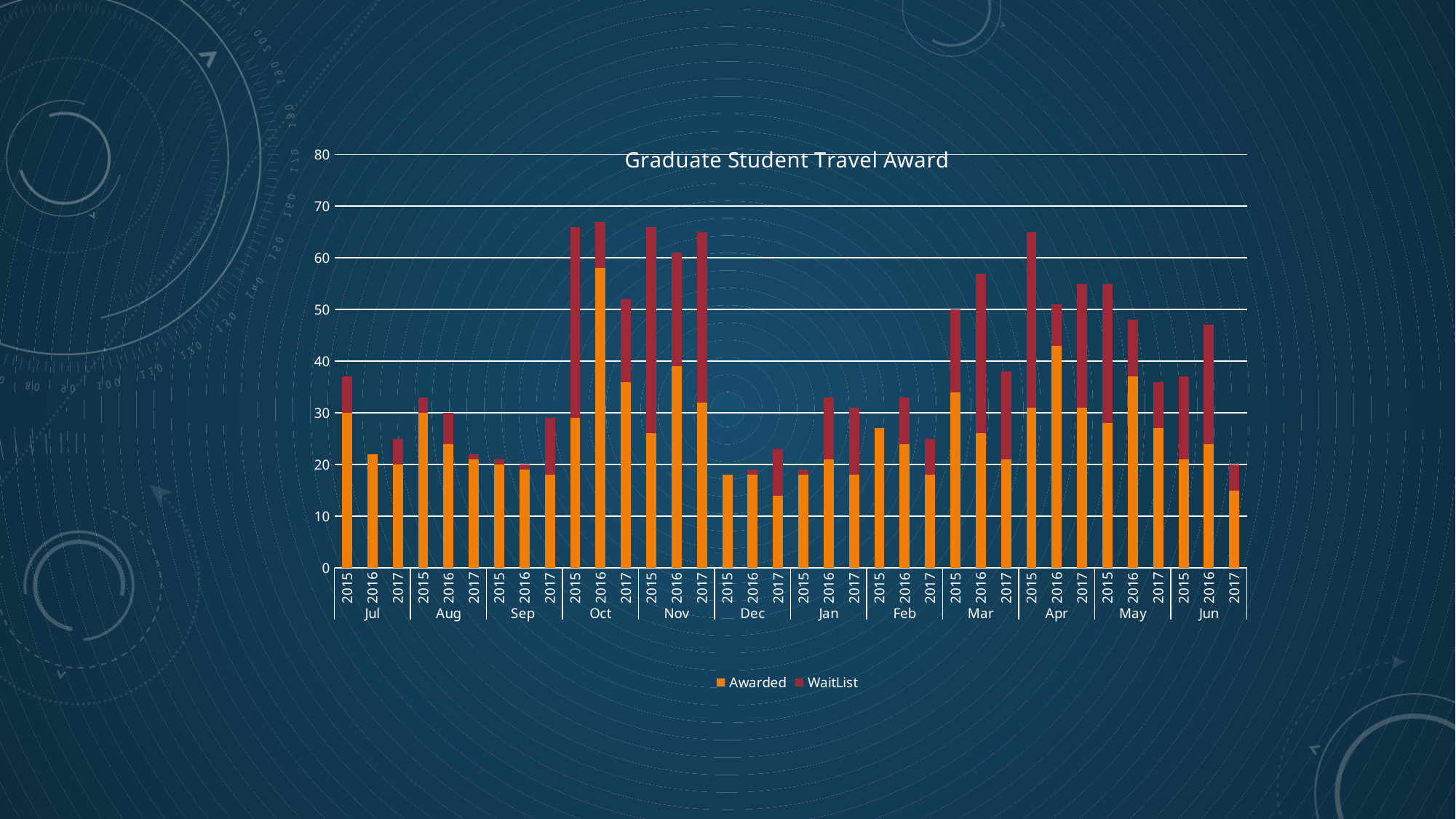
Is the total height of the Jun 2017 bar greater or less than 30? less Which bar is taller in total, Apr 2015 or Jun 2017? Apr 2015 How many series does the legend list? 2 Is the total height of the Oct 2016 bar greater or less than 60? greater How many months are shown along the x axis? 12 Which bar is taller in total, Oct 2016 or Dec 2015? Oct 2016 What is the title of the chart? Graduate Student Travel Award What are the two series named in the legend? Awarded and WaitList How many bars are plotted in total on the chart? 36 Is the Awarded value for Apr 2016 greater or less than 40? greater What kind of chart is shown on the slide? Stacked bar chart